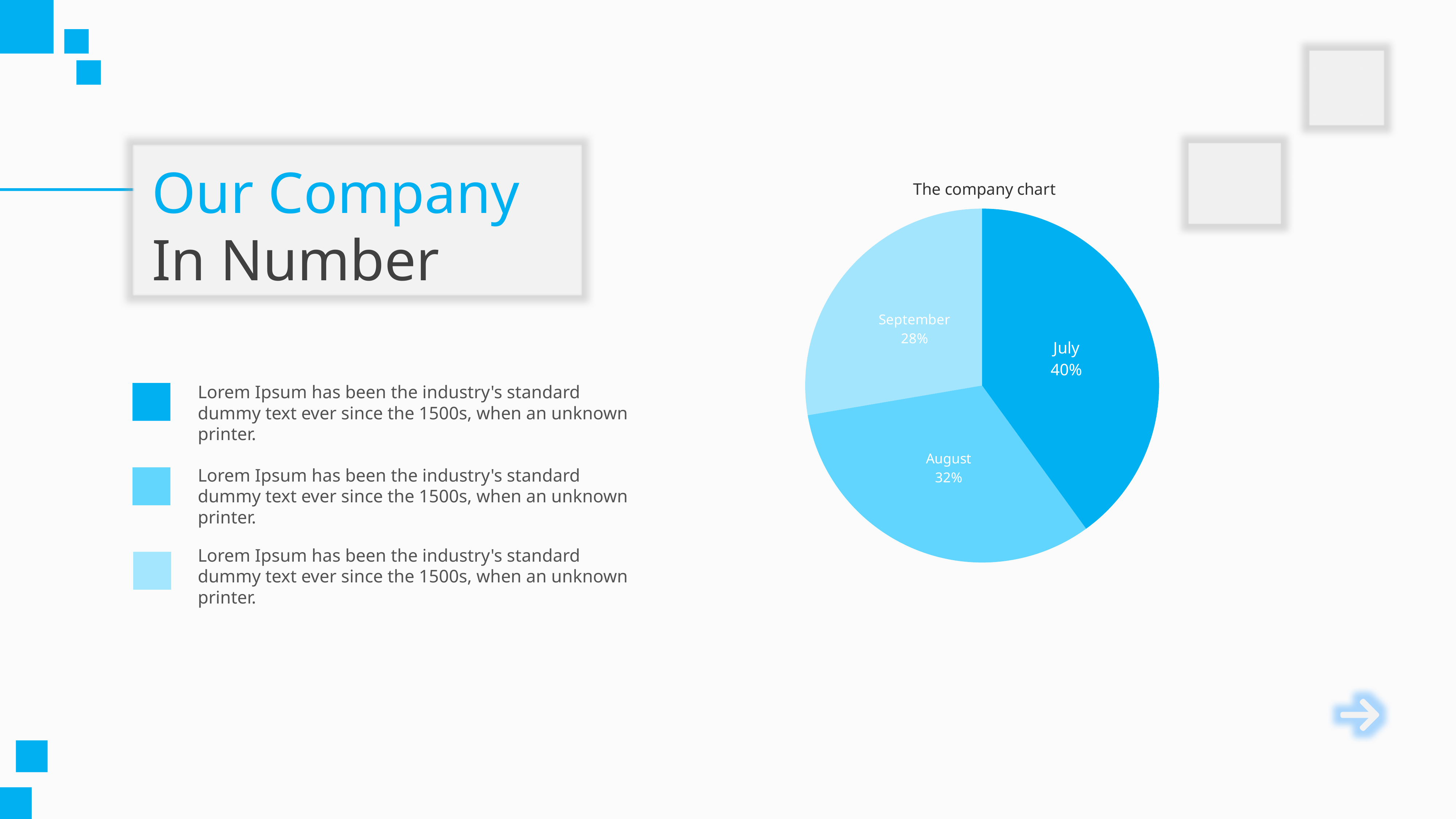
What is the difference in percentage points between the August and September slices? 4 What type of chart is shown on the slide? pie chart What percentage does the July slice show? 40% What percentage does the September slice show? 28% Which slice is larger, August or September? August Which month has the smallest slice of the pie? September What percentage does the August slice show? 32% What is the difference in percentage points between the July and September slices? 12 How many slices does the pie chart have? 3 What is the title of the chart? The company chart Which slice of the pie is the darkest blue? July Which month has the largest slice of the pie? July